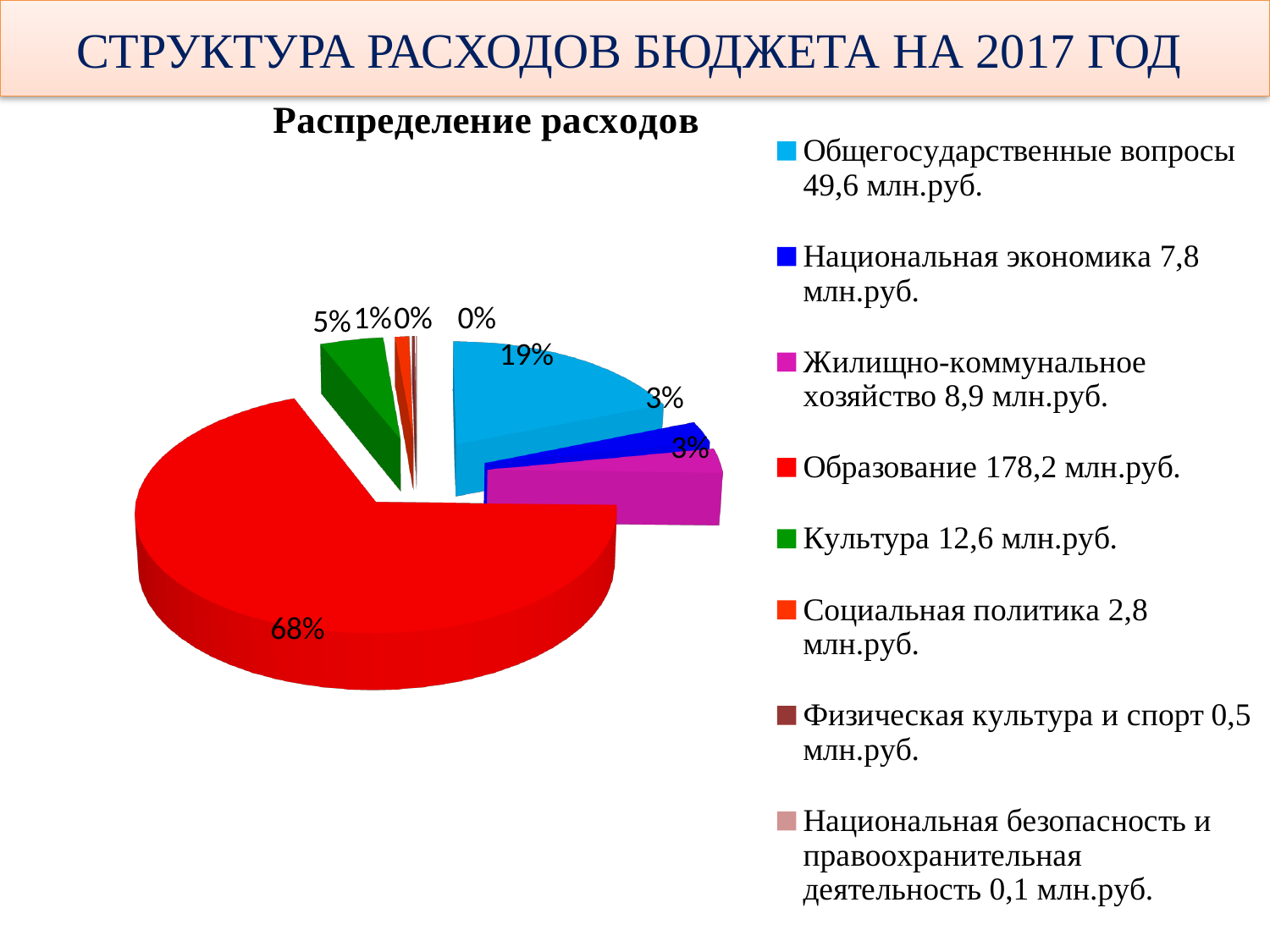
Which category has the largest slice of the pie? Образование What share of the pie does Общегосударственные вопросы take? 19% What is the title of the chart? Распределение расходов How many categories does the legend list? 8 What kind of chart is shown on the slide? pie chart What share of the pie does Культура take? 5% Which is larger, the slice for Общегосударственные вопросы or the slice for Культура? Общегосударственные вопросы According to the legend, what is the amount for Жилищно-коммунальное хозяйство? 8,9 млн.руб. What share of the pie does Образование take? 68% According to the legend, what is the amount for Образование? 178,2 млн.руб. What is the difference in percentage points between the Образование slice and the Общегосударственные вопросы slice? 49